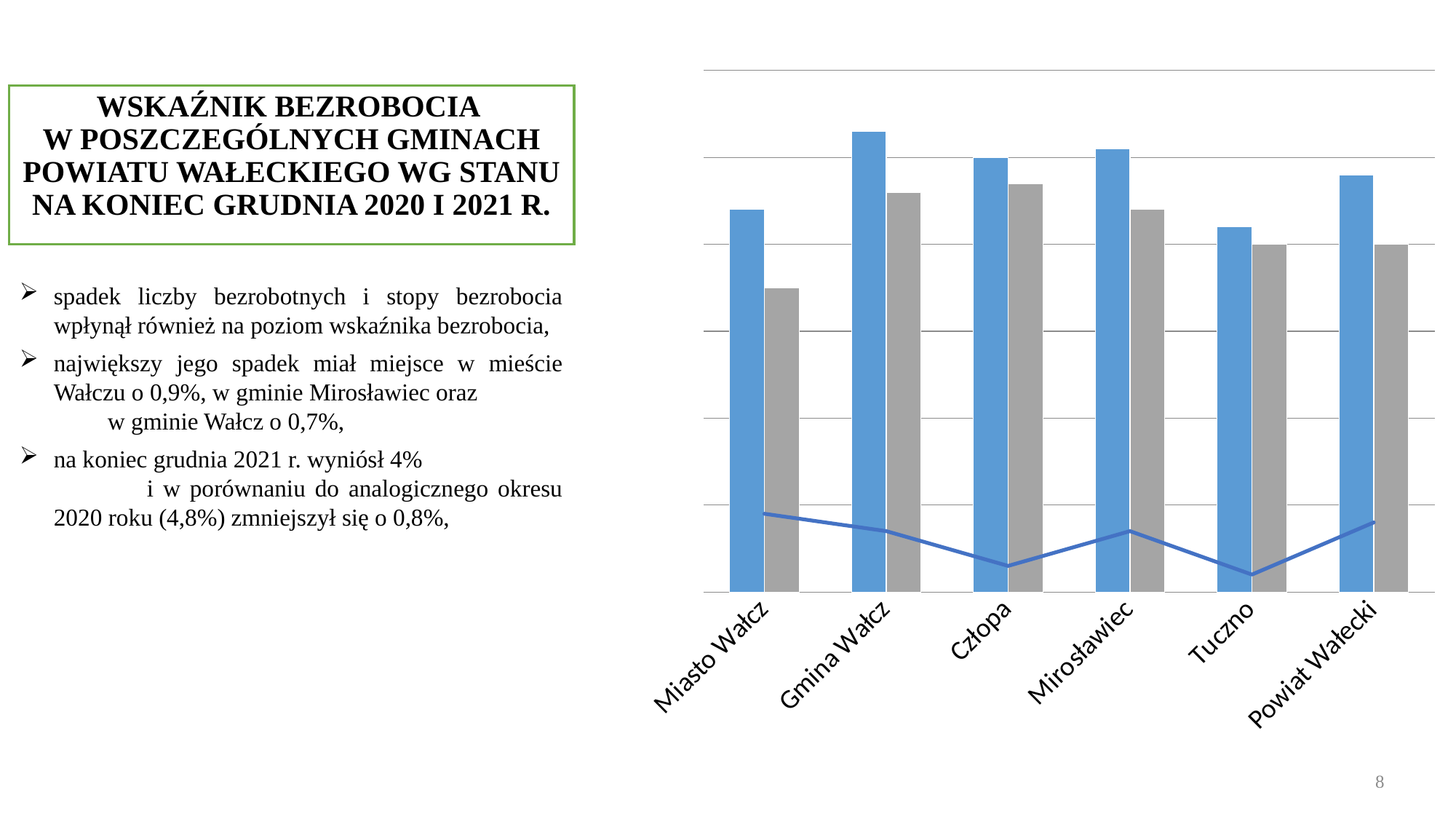
Does the line rise or fall from Miasto Wałcz to Człopa? falls Which has the taller blue bar, Mirosławiec or Powiat Wałecki? Mirosławiec Which category has the shortest blue bar? Tuczno Which has the taller blue bar, Człopa or Tuczno? Człopa For Miasto Wałcz, which bar is taller, the blue one or the gray one? the blue one Which category has the shortest gray bar? Miasto Wałcz How many categories are shown on the x axis of the chart? 6 What kind of chart is shown on the slide? combination bar and line chart Which category has the tallest blue bar? Gmina Wałcz What is the label of the last category on the x axis? Powiat Wałecki